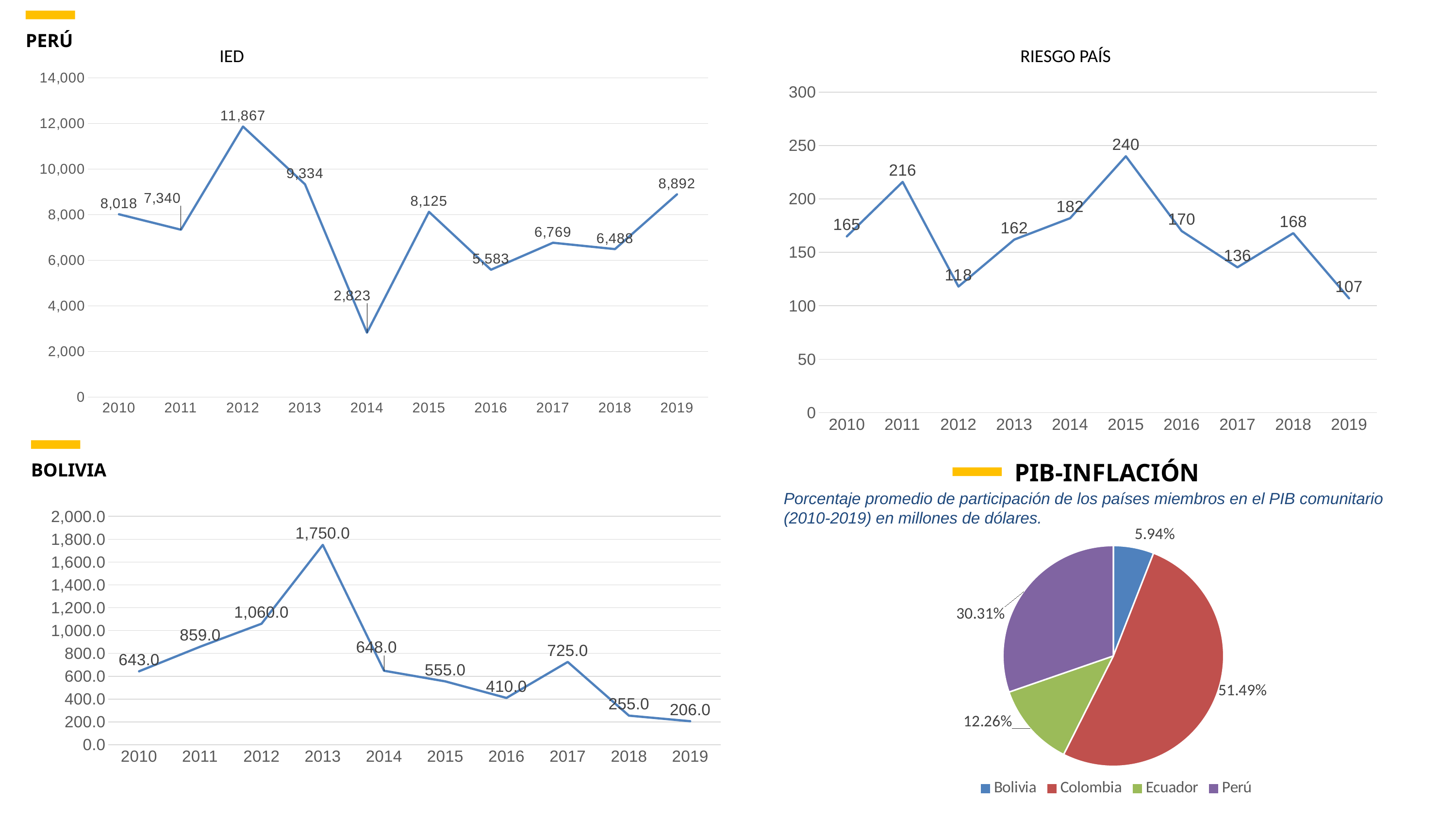
In the RIESGO PAÍS chart (top right), what is the value for 2015? 240 In the RIESGO PAÍS chart (top right), how many years are plotted on the x axis? 10 In the IED chart (top left), which year has the lowest value? 2014 In the BOLIVIA chart (bottom left), do the values rise or fall from 2017 to 2019? fall In the BOLIVIA chart (bottom left), what is the value for 2013? 1,750.0 In the IED chart (top left), what is the value for 2012? 11,867 In the PIB-INFLACIÓN pie chart (bottom right), how many entries does the legend list? 4 In the IED chart (top left), what is the difference between the 2012 and 2014 values? 9,044 In the PIB-INFLACIÓN pie chart (bottom right), what share does Colombia have? 51.49% In the RIESGO PAÍS chart (top right), which is larger, the value for 2011 or the value for 2014? 2011 In the BOLIVIA chart (bottom left), what is the difference between the 2017 and 2018 values? 470.0 In the RIESGO PAÍS chart (top right), which year has the lowest value? 2019